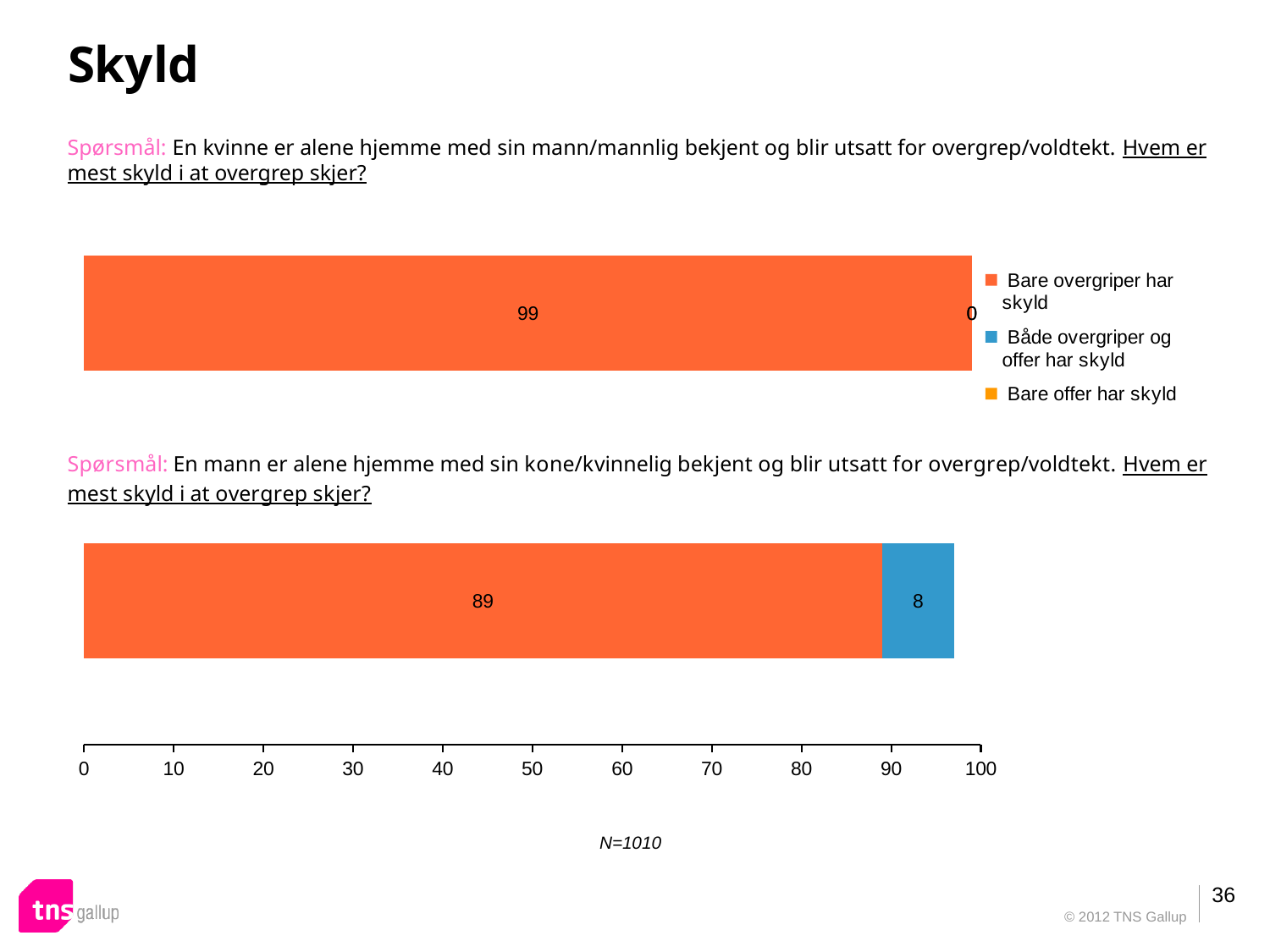
What kind of chart is shown on the slide? Bar chart How many series does the legend list? 3 What colour represents 'Både overgriper og offer har skyld' in the legend? Blue In the bottom chart, is the value for 'Bare overgriper har skyld' greater or less than 80? greater In the bottom chart, which is larger: 'Bare overgriper har skyld' or 'Både overgriper og offer har skyld'? Bare overgriper har skyld In the bottom chart, is the value for 'Både overgriper og offer har skyld' greater or less than 10? less In the top chart, what is the value for 'Bare overgriper har skyld'? 99 In the bottom chart, what is the value for 'Både overgriper og offer har skyld'? 8 What is the maximum value shown on the horizontal axis? 100 In the bottom chart, what is the total of the two labelled segments? 97 In the bottom chart, what is the value for 'Bare overgriper har skyld'? 89 What is the difference between the 'Bare overgriper har skyld' values in the top chart and the bottom chart? 10